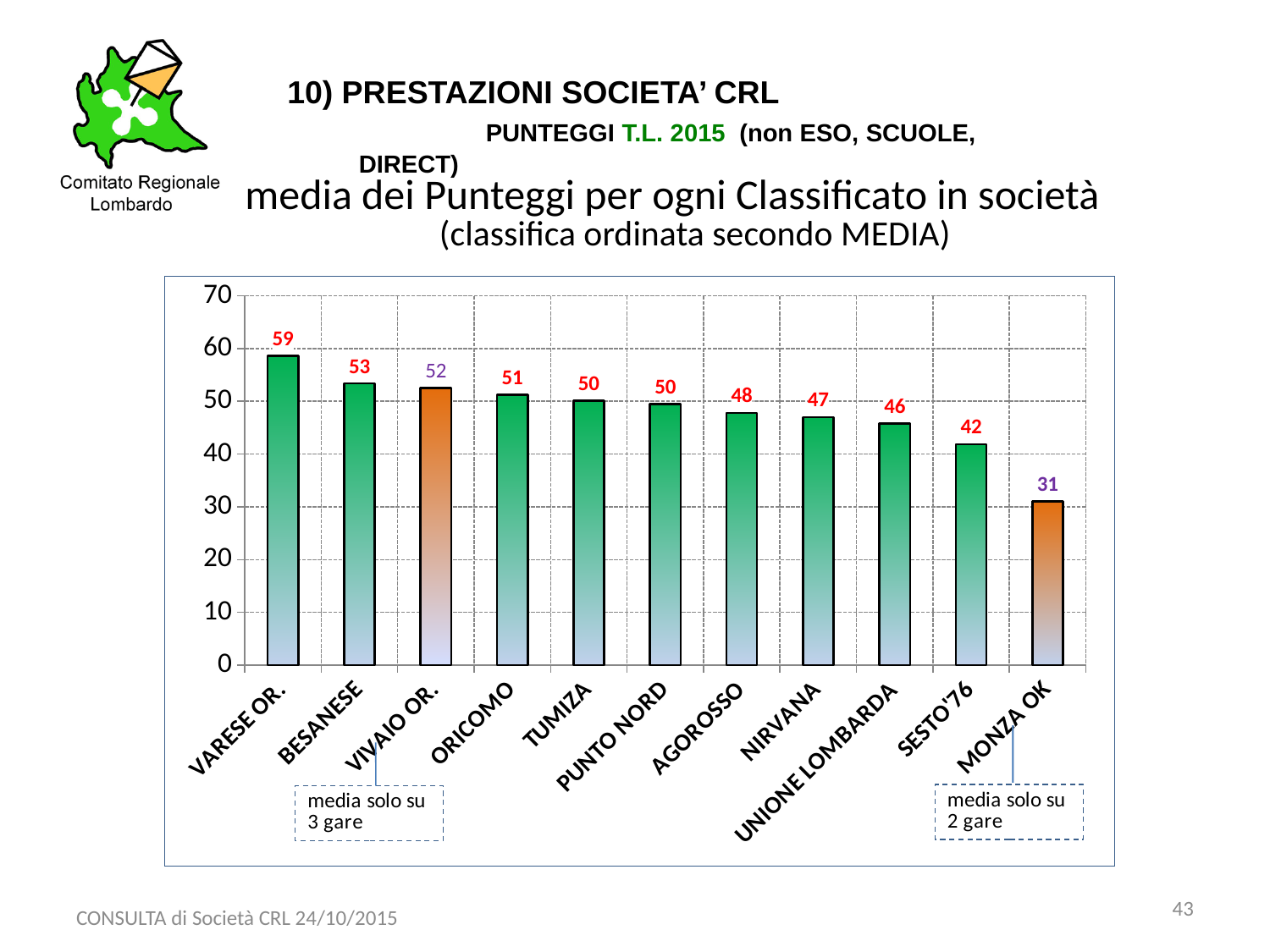
Do the values rise or fall from left to right along the x axis? fall What is the difference between the values for VARESE OR. and BESANESE? 6 How many categories are shown on the x axis? 11 What is the difference between the values for SESTO'76 and MONZA OK? 11 What is the value for UNIONE LOMBARDA? 46 What is the value for MONZA OK? 31 Which category has the lowest value? MONZA OK What kind of chart is shown on the slide? bar chart What is the value for VARESE OR.? 59 Is the value for AGOROSSO greater or less than 40? greater Which category has the highest value? VARESE OR. Which is larger, the value for ORICOMO or the value for NIRVANA? ORICOMO